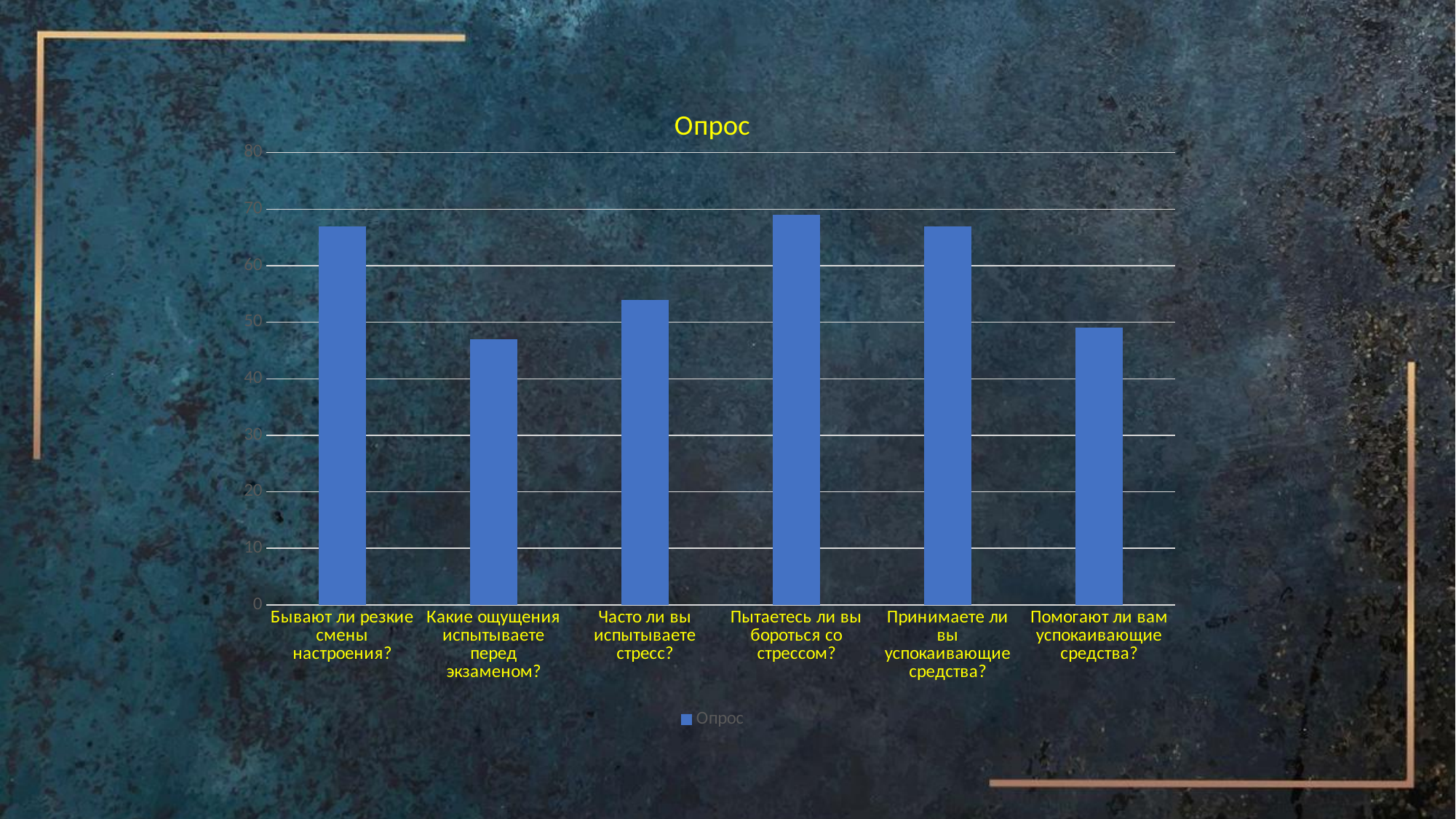
What is the title of the chart? Опрос Is the value for "Какие ощущения испытываете перед экзаменом?" greater or less than 50? less What type of chart is shown on the slide? bar chart How many series does the chart legend list? 1 Which is larger: the value for "Бывают ли резкие смены настроения?" or the value for "Помогают ли вам успокаивающие средства?"? Бывают ли резкие смены настроения? Is the value for "Помогают ли вам успокаивающие средства?" greater or less than 40? greater Which is larger: the value for "Часто ли вы испытываете стресс?" or the value for "Какие ощущения испытываете перед экзаменом?"? Часто ли вы испытываете стресс? Is the value for "Бывают ли резкие смены настроения?" greater or less than 60? greater How many categories (questions) are shown on the x axis of the chart? 6 Which category has the highest bar in the chart? Пытаетесь ли вы бороться со стрессом?